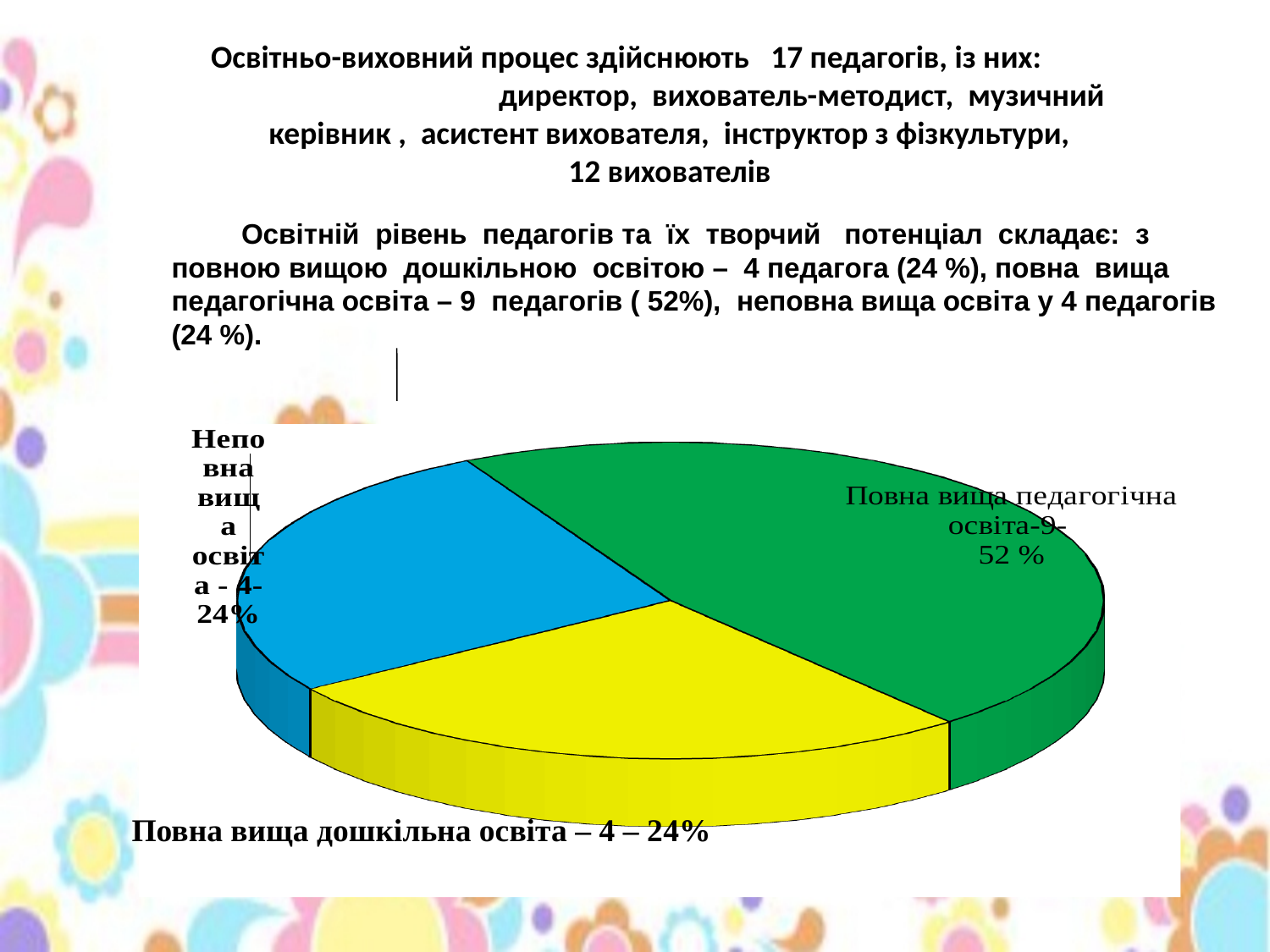
How many teachers have Неповна вища освіта according to the chart label? 4 How many slices does the pie chart have? 3 What percentage share is shown for Повна вища дошкільна освіта? 24% How many teachers have Повна вища педагогічна освіта according to the chart label? 9 Which slice of the pie chart is the largest? Повна вища педагогічна освіта By how many percentage points does the share for Повна вища педагогічна освіта exceed the share for Неповна вища освіта? 28 What percentage share is shown for Повна вища педагогічна освіта? 52 % What colour is the slice for Повна вища дошкільна освіта? yellow Which is larger: the slice for Повна вища педагогічна освіта or the slice for Неповна вища освіта? Повна вища педагогічна освіта What colour is the slice for Повна вища педагогічна освіта? green What kind of chart is shown on the slide? pie chart What percentage share is shown for Неповна вища освіта? 24%